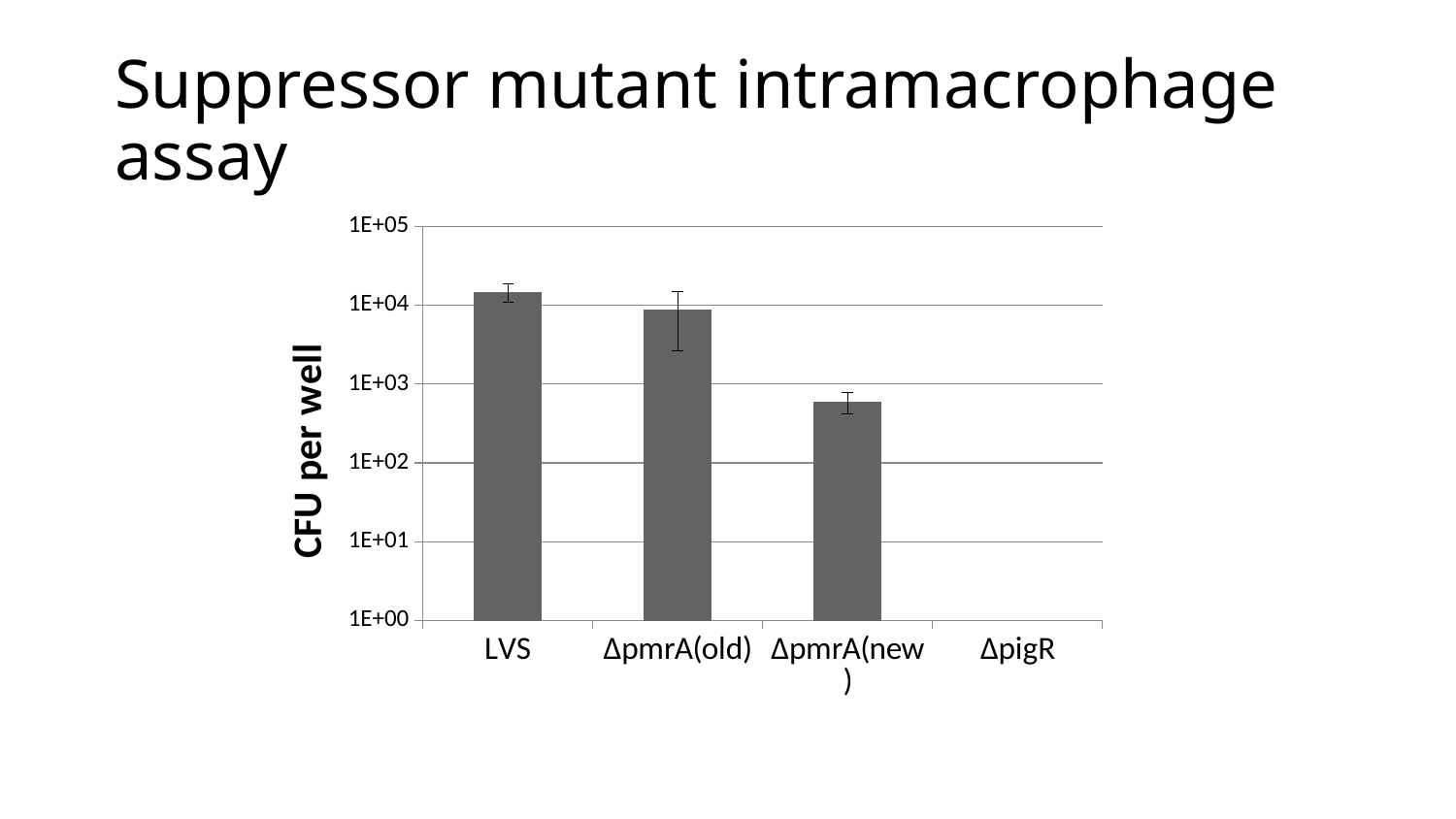
Which has a larger CFU per well, LVS or ΔpmrA(new)? LVS Which category has the lowest CFU per well? ΔpigR Which category has the highest CFU per well? LVS Do the bar values rise or fall from left to right across the x axis? fall Is the value for ΔpmrA(new) greater or less than 1E+03? less Is the value for LVS greater or less than 1E+04? greater Is the value for ΔpmrA(new) greater or less than 1E+02? greater What is the label of the y axis? CFU per well How many categories are shown on the x axis of the chart? 4 Which has a larger CFU per well, ΔpmrA(old) or ΔpmrA(new)? ΔpmrA(old) What kind of chart is shown on the slide? bar chart